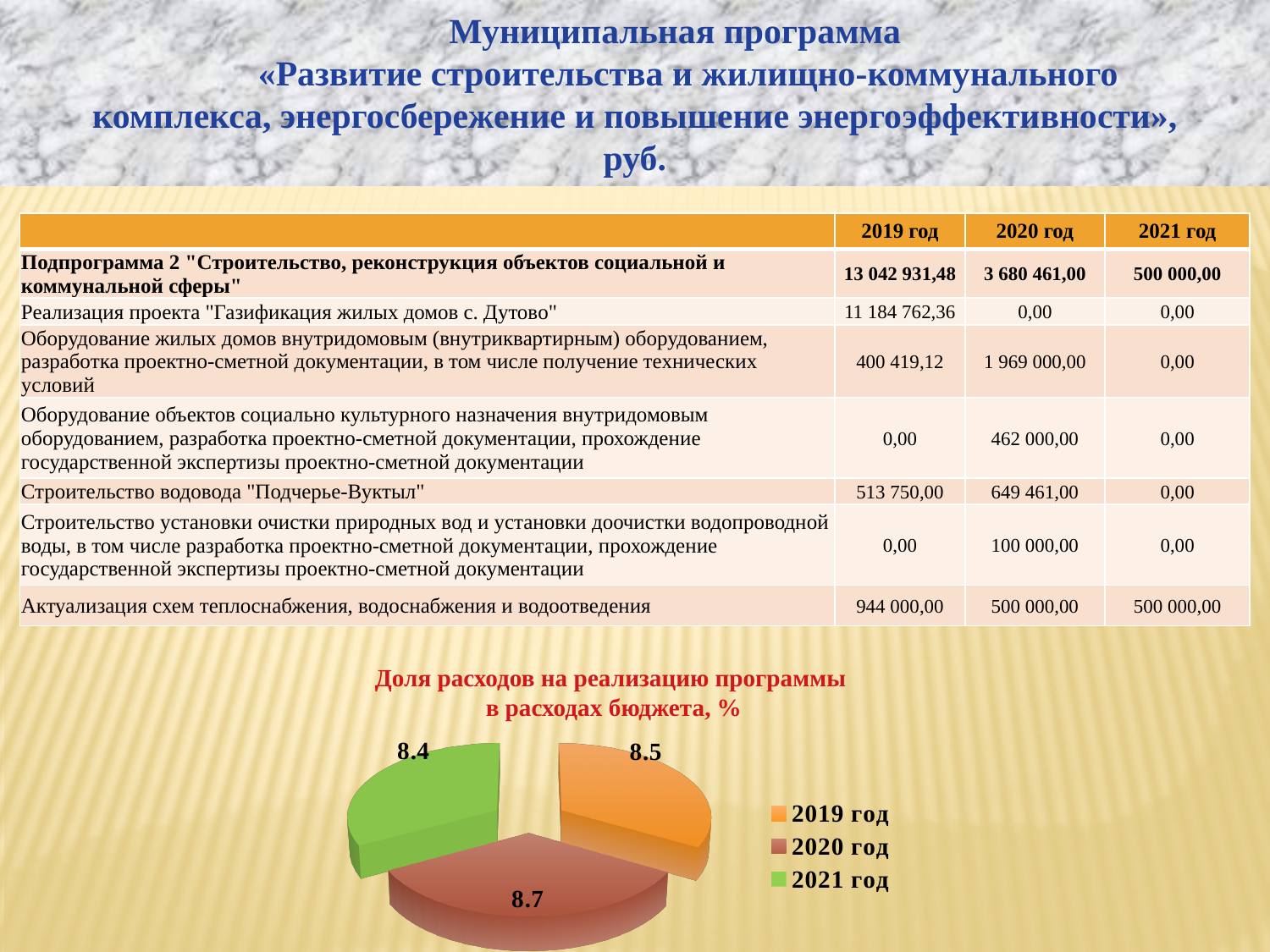
What kind of chart is shown on the slide? pie chart What is the title of the pie chart? Доля расходов на реализацию программы в расходах бюджета, % How many slices does the pie chart have? 3 Which year has the lowest value in the pie chart? 2021 год What is the difference between the values for 2020 год and 2021 год in the pie chart? 0.3 In the pie chart, what is the value for 2020 год? 8.7 How many entries does the pie chart legend list? 3 What is the difference between the values for 2020 год and 2019 год in the pie chart? 0.2 In the pie chart, what is the value for 2021 год? 8.4 Which year has the highest value in the pie chart? 2020 год In the pie chart, which is larger: the value for 2019 год or 2021 год? 2019 год In the pie chart, what is the value for 2019 год? 8.5